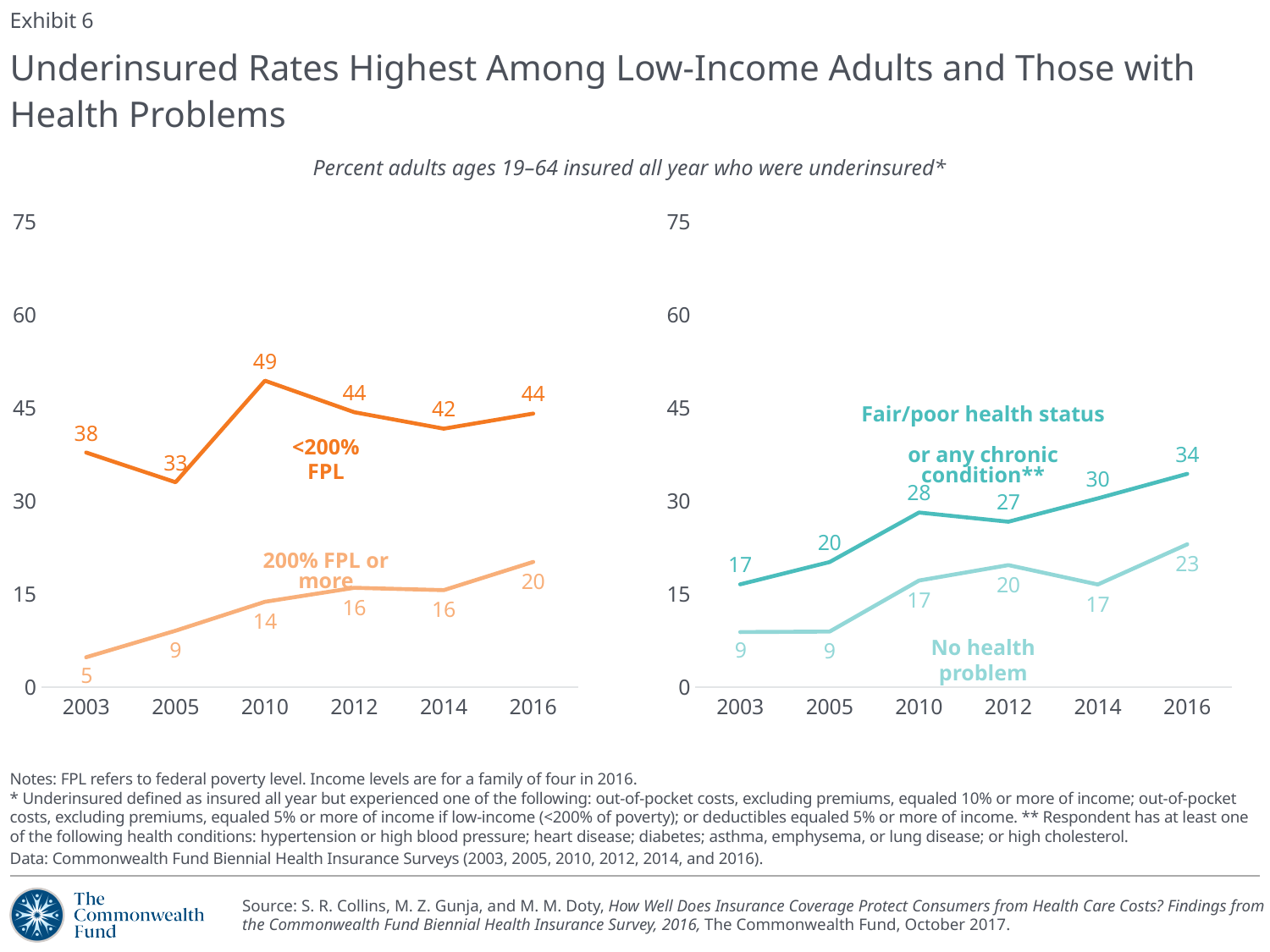
In the left chart, what is the difference between the <200% FPL and 200% FPL or more values in 2016? 24 In the left chart, what is the value for <200% FPL in 2010? 49 What type of chart is the left chart? line chart In the right chart, which is larger in 2014: Fair/poor health status or any chronic condition, or No health problem? Fair/poor health status or any chronic condition In the right chart, what is the value for No health problem in 2012? 20 In the left chart, what is the value for 200% FPL or more in 2003? 5 In the left chart, is the value for <200% FPL in 2005 greater or less than 30? greater How many years are shown on the x axis of the right chart? 6 In the right chart, does the No health problem line rise or fall from 2003 to 2016 overall? rise In the right chart, in which year is the Fair/poor health status or any chronic condition line lowest? 2003 In the right chart, what is the value for Fair/poor health status or any chronic condition in 2016? 34 In the left chart, in which year is the <200% FPL line highest? 2010